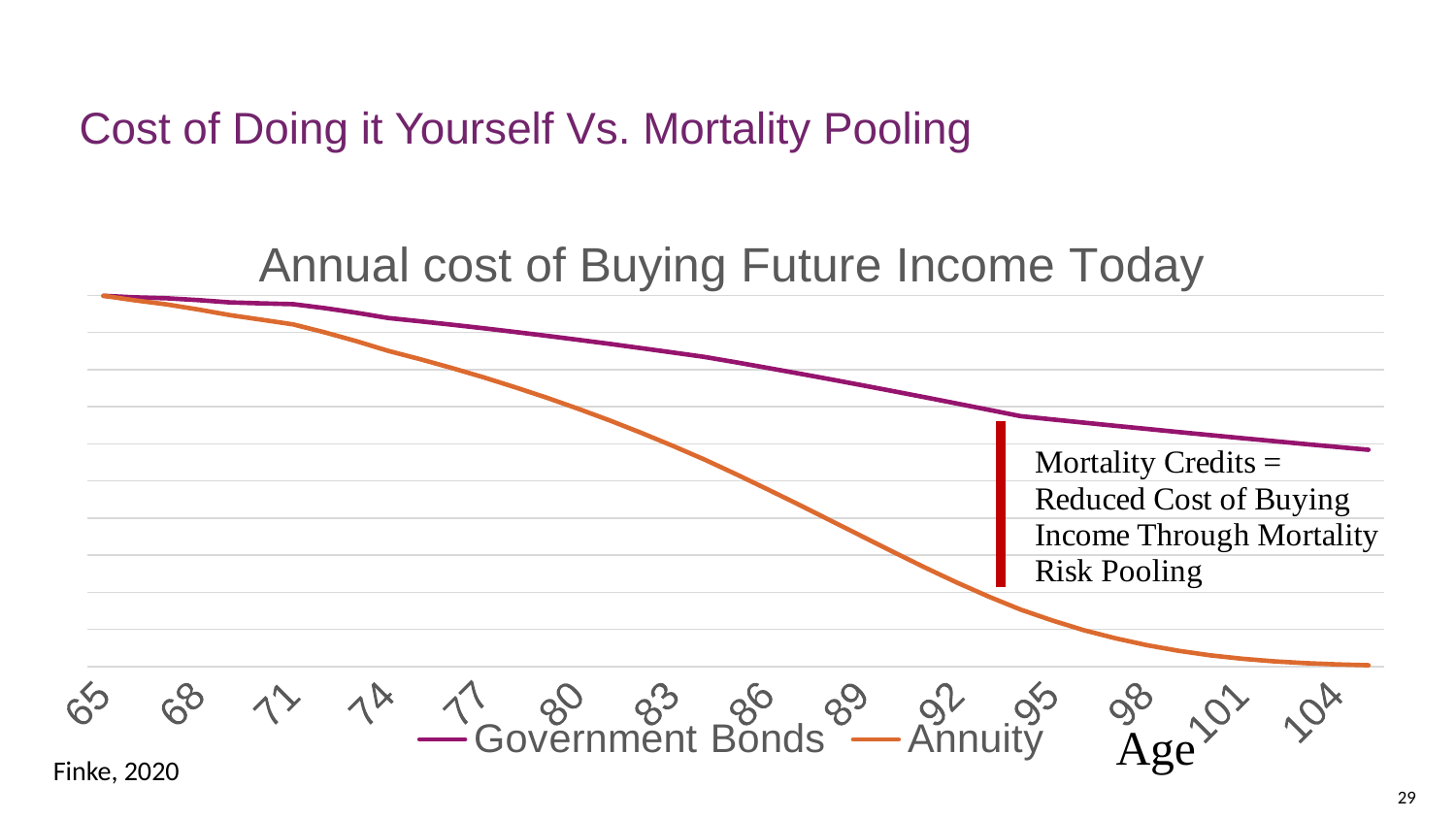
Does the Annuity line rise or fall as age increases along the x axis? fall What are the two series named in the chart's legend? Government Bonds and Annuity How many series does the chart's legend list? 2 What is the title of the chart? Annual cost of Buying Future Income Today At age 104, which series has the lower value, Government Bonds or Annuity? Annuity How many age labels are shown along the x axis? 14 What kind of chart is shown on the slide? line chart Does the Government Bonds line rise or fall as age increases along the x axis? fall At age 89, which series has the higher value, Government Bonds or Annuity? Government Bonds Which series falls more steeply between age 80 and age 95, Government Bonds or Annuity? Annuity What is the first age label on the x axis? 65 What is the last age label on the x axis? 104